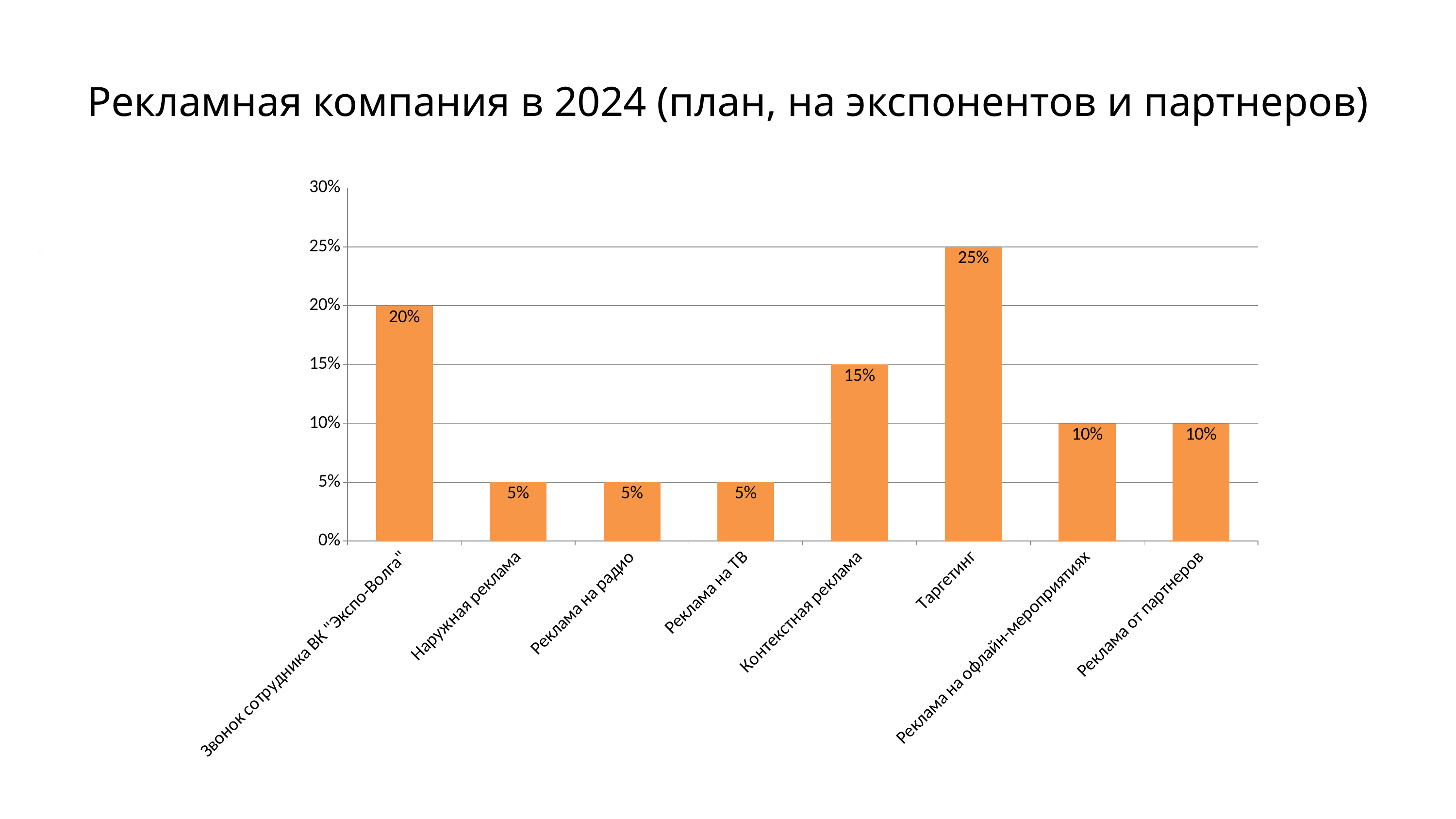
What is the value for Таргетинг? 25% What is the title of the chart? Рекламная компания в 2024 (план, на экспонентов и партнеров) What is the difference between the values for Звонок сотрудника ВК "Экспо-Волга" and Наружная реклама? 15% How many categories are shown on the x axis? 8 What is the value for Контекстная реклама? 15% What is the value for Реклама на радио? 5% Which is larger, the value for Реклама от партнеров or the value for Реклама на ТВ? Реклама от партнеров What is the difference between the values for Таргетинг and Контекстная реклама? 10% What is the value for Звонок сотрудника ВК "Экспо-Волга"? 20% How many categories have a value of 5%? 3 What kind of chart is shown on the slide? Bar chart Which category has the highest value? Таргетинг